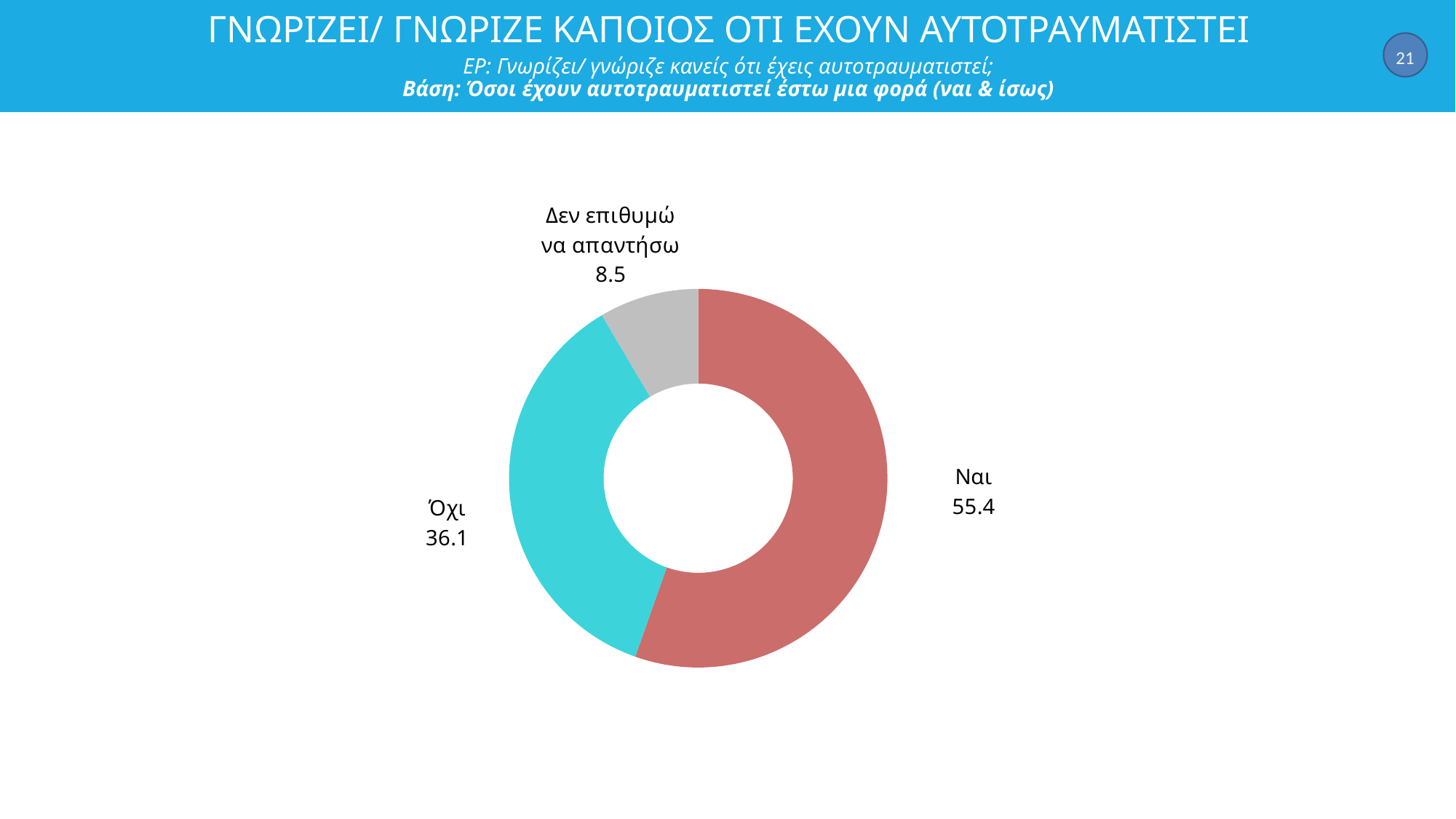
What kind of chart is shown on the slide? Doughnut chart What colour is the slice for Όχι? Cyan Which is larger, the value for Όχι or the value for Δεν επιθυμώ να απαντήσω? Όχι Which category has the highest value? Ναι What is the value for Δεν επιθυμώ να απαντήσω? 8.5 Which category has the lowest value? Δεν επιθυμώ να απαντήσω How many categories are shown in the chart? 3 What is the difference between the values for Όχι and Δεν επιθυμώ να απαντήσω? 27.6 What is the difference between the values for Ναι and Όχι? 19.3 What is the value for Όχι? 36.1 What is the value for Ναι? 55.4 What colour is the slice for Ναι? Red